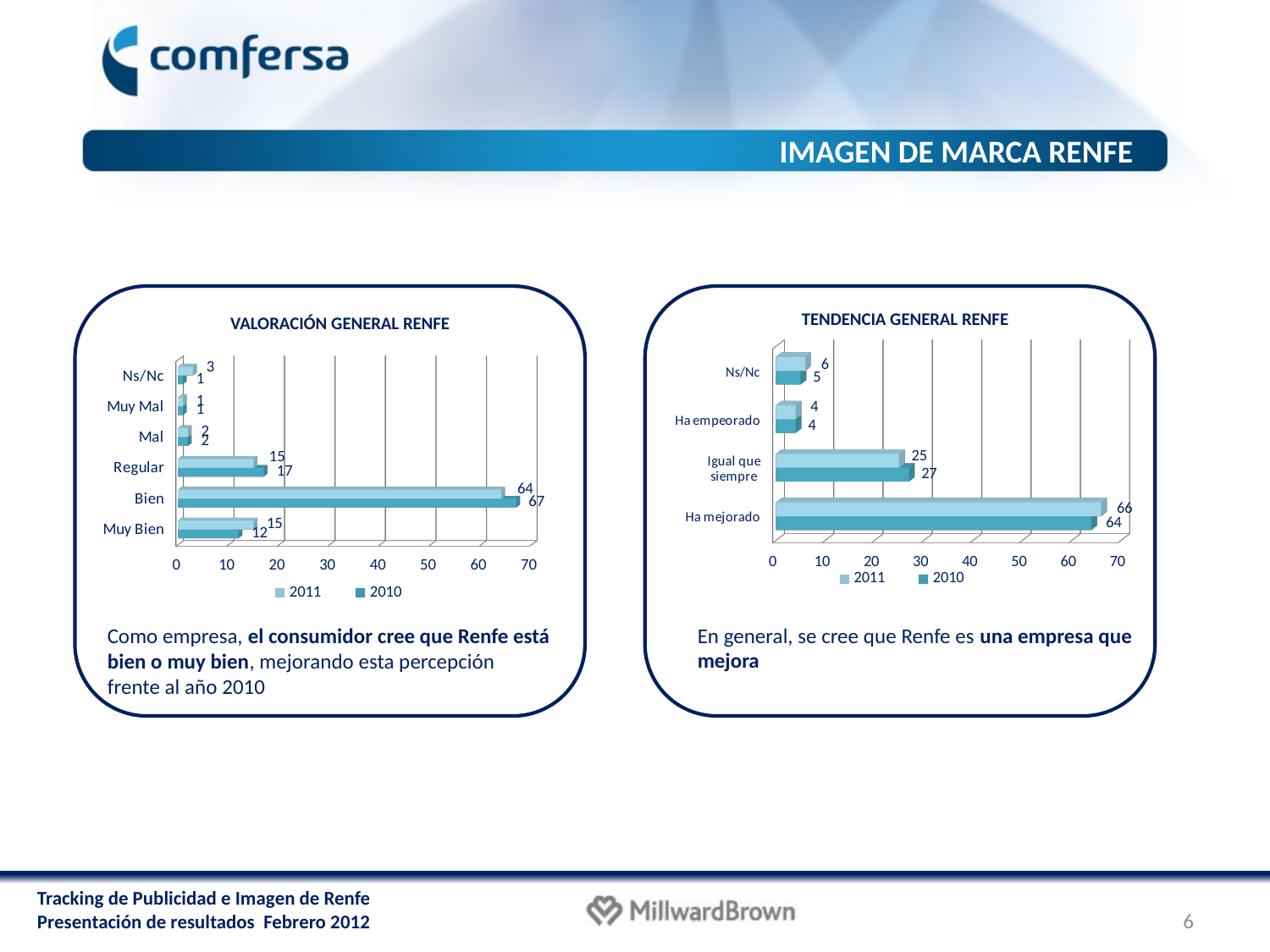
In the TENDENCIA GENERAL RENFE chart, which is larger for Igual que siempre, the 2011 value or the 2010 value? 2010 In the TENDENCIA GENERAL RENFE chart, which category has the lowest 2011 value? Ha empeorado In the VALORACIÓN GENERAL RENFE chart, which category has the highest 2010 value? Bien In the TENDENCIA GENERAL RENFE chart, what is the 2011 value for Ha mejorado? 66 In the VALORACIÓN GENERAL RENFE chart, how many categories are shown on the vertical axis? 6 In the VALORACIÓN GENERAL RENFE chart, what is the 2011 value for Bien? 64 In the VALORACIÓN GENERAL RENFE chart, what is the 2010 value for Regular? 17 In the TENDENCIA GENERAL RENFE chart, what is the 2010 value for Igual que siempre? 27 What kind of chart is the TENDENCIA GENERAL RENFE chart? Bar chart In the VALORACIÓN GENERAL RENFE chart, what is the difference between the 2011 and 2010 values for Muy Bien? 3 In the VALORACIÓN GENERAL RENFE chart, how many series does the legend list? 2 In the TENDENCIA GENERAL RENFE chart, what is the difference between the 2011 and 2010 values for Ha mejorado? 2